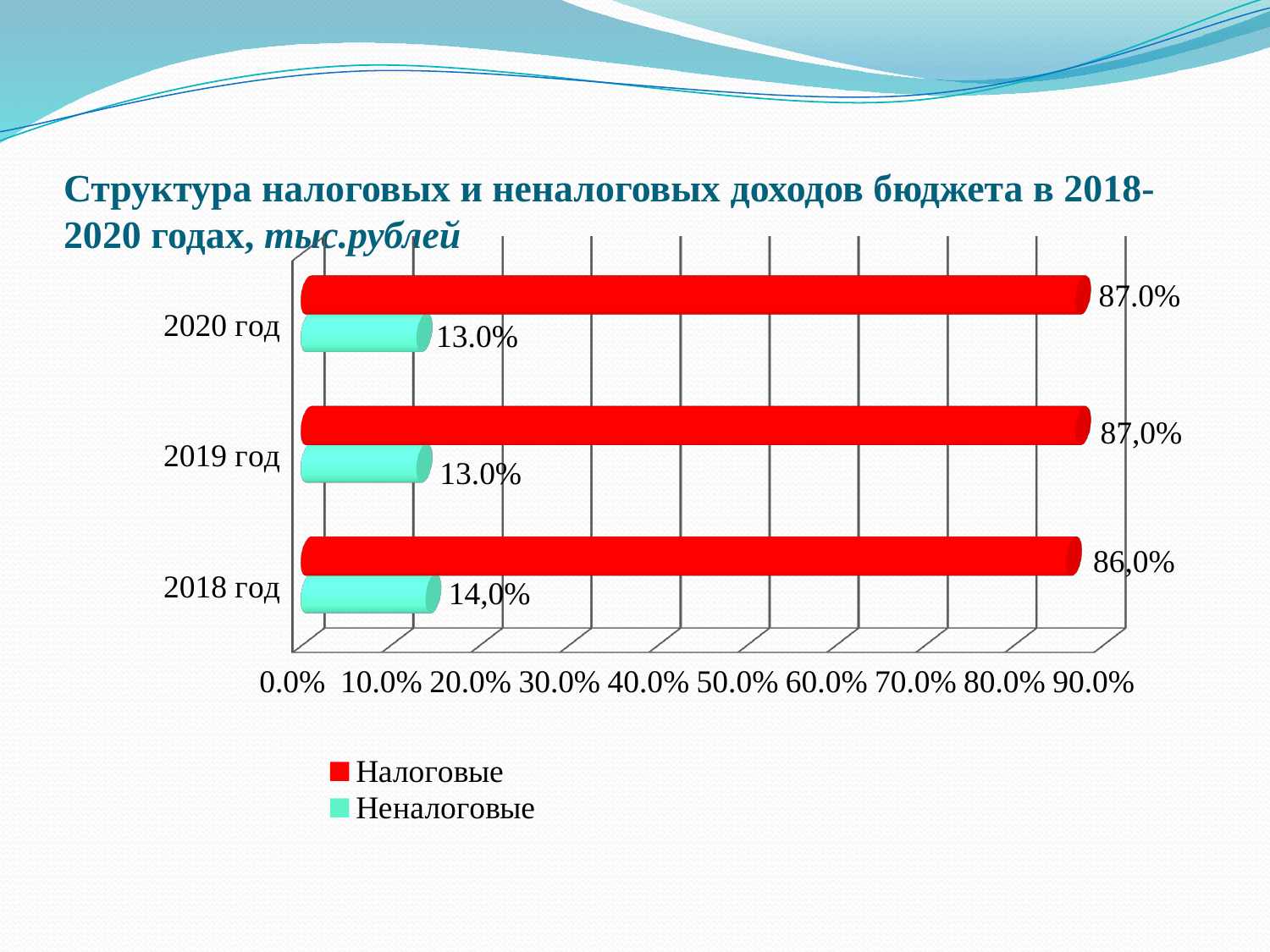
What is the value for Налоговые in 2020 год? 87.0% What is the value for Неналоговые in 2018 год? 14,0% How many series does the legend list? 2 How many years are shown on the chart? 3 What is the value for Неналоговые in 2019 год? 13.0% Is the value for Неналоговые in 2020 год greater or less than 20.0%? less Which year has the lowest value for Налоговые? 2018 год What kind of chart is shown on the slide? bar chart Which is larger in 2018 год, Налоговые or Неналоговые? Налоговые What is the value for Налоговые in 2018 год? 86,0% What is the difference between the Налоговые and Неналоговые values in 2020 год? 74.0% Which year has the highest value for Неналоговые? 2018 год